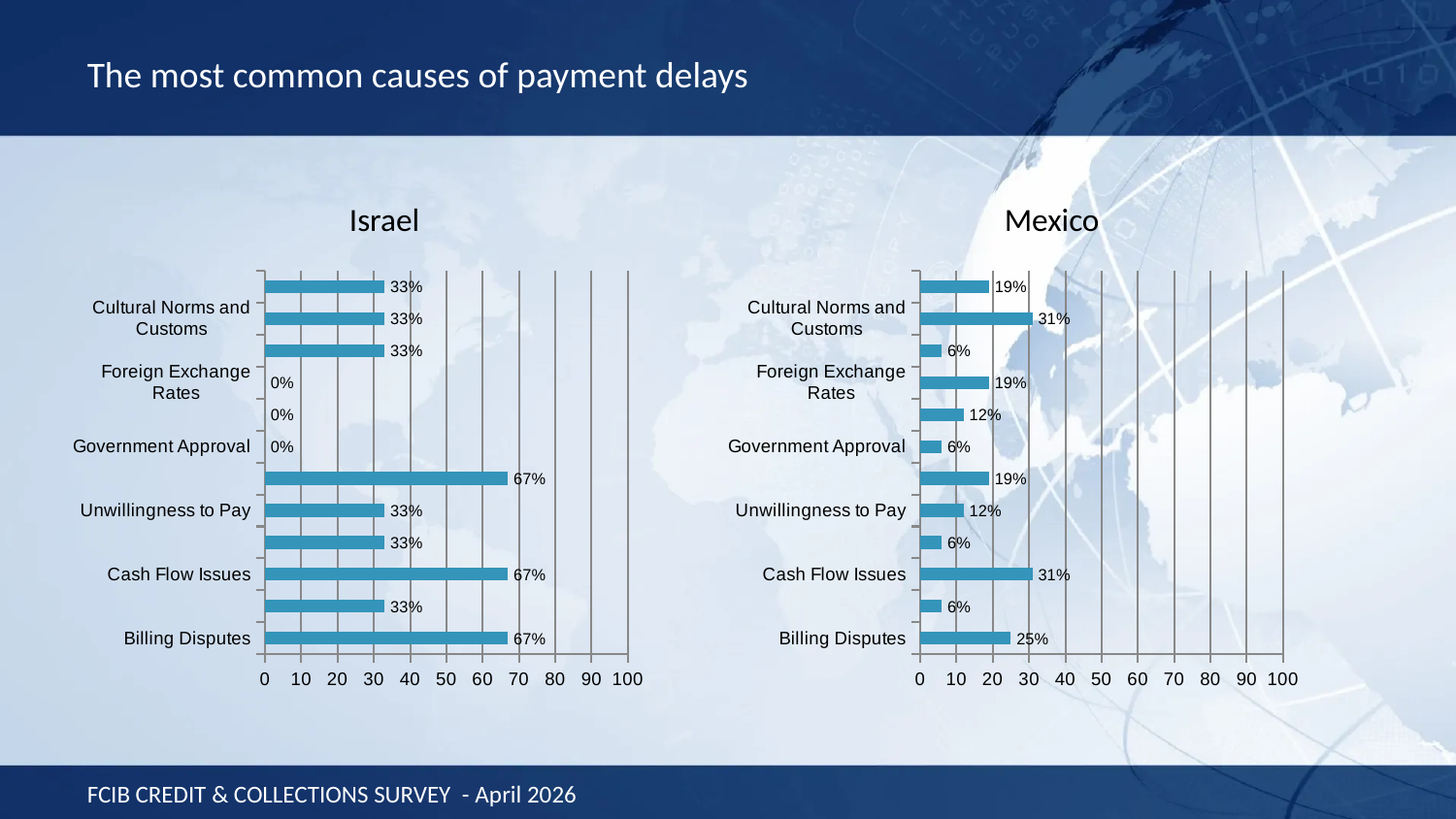
What is the title of the chart on the left side of the slide? Israel In the Mexico chart, what is the value for Government Approval? 6% In the Israel chart, what is the value for Unwillingness to Pay? 33% In the Israel chart, which is larger, Billing Disputes or Cultural Norms and Customs? Billing Disputes In the Mexico chart, which is larger, Cash Flow Issues or Unwillingness to Pay? Cash Flow Issues In the Mexico chart, what is the difference between Cultural Norms and Customs and Billing Disputes? 6% In the Israel chart, what is the difference between Cash Flow Issues and Unwillingness to Pay? 34% In the Israel chart, what is the value for Cash Flow Issues? 67% In the Israel chart, what is the value for Government Approval? 0% What type of chart is the Mexico chart? Bar chart In the Mexico chart, what is the value for Billing Disputes? 25% In the Mexico chart, what is the value for Foreign Exchange Rates? 19%